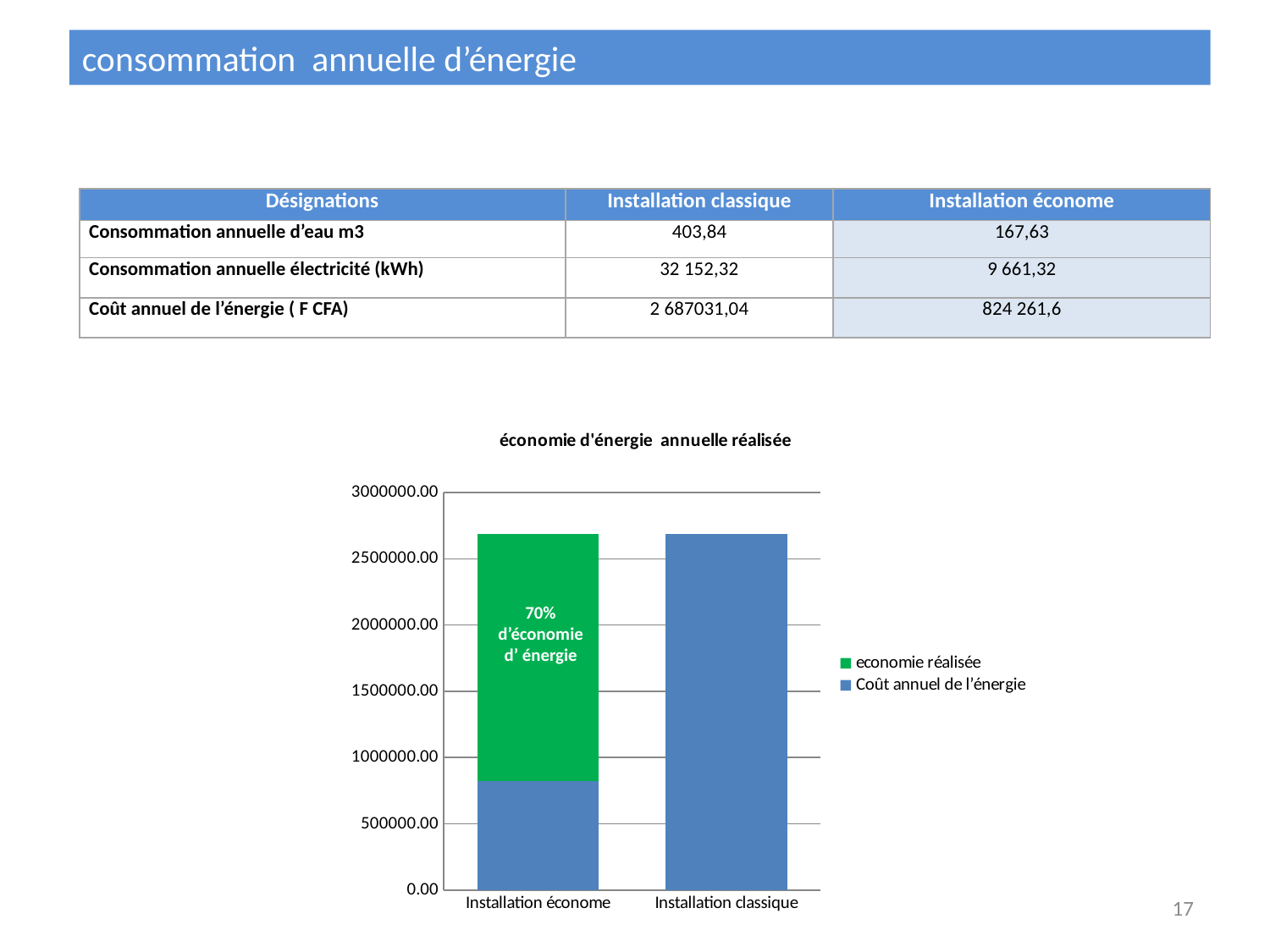
Is the economie réalisée segment for Installation économe greater or less than 1500000.00? greater What kind of chart is shown on the slide? bar chart Is the Coût annuel de l'énergie value for Installation économe greater or less than 1000000.00? less Which category has the highest Coût annuel de l'énergie value? Installation classique How many categories are shown on the x axis of the chart? 2 What is the title of the chart? économie d'énergie annuelle réalisée Which series is shown in green in the chart? economie réalisée How many series does the chart legend list? 2 Which category has the larger Coût annuel de l'énergie value, Installation économe or Installation classique? Installation classique Which category has the lowest Coût annuel de l'énergie value? Installation économe What percentage of energy savings is printed on the green segment of the Installation économe bar? 70% Is the Coût annuel de l'énergie value for Installation classique greater or less than 2500000.00? greater